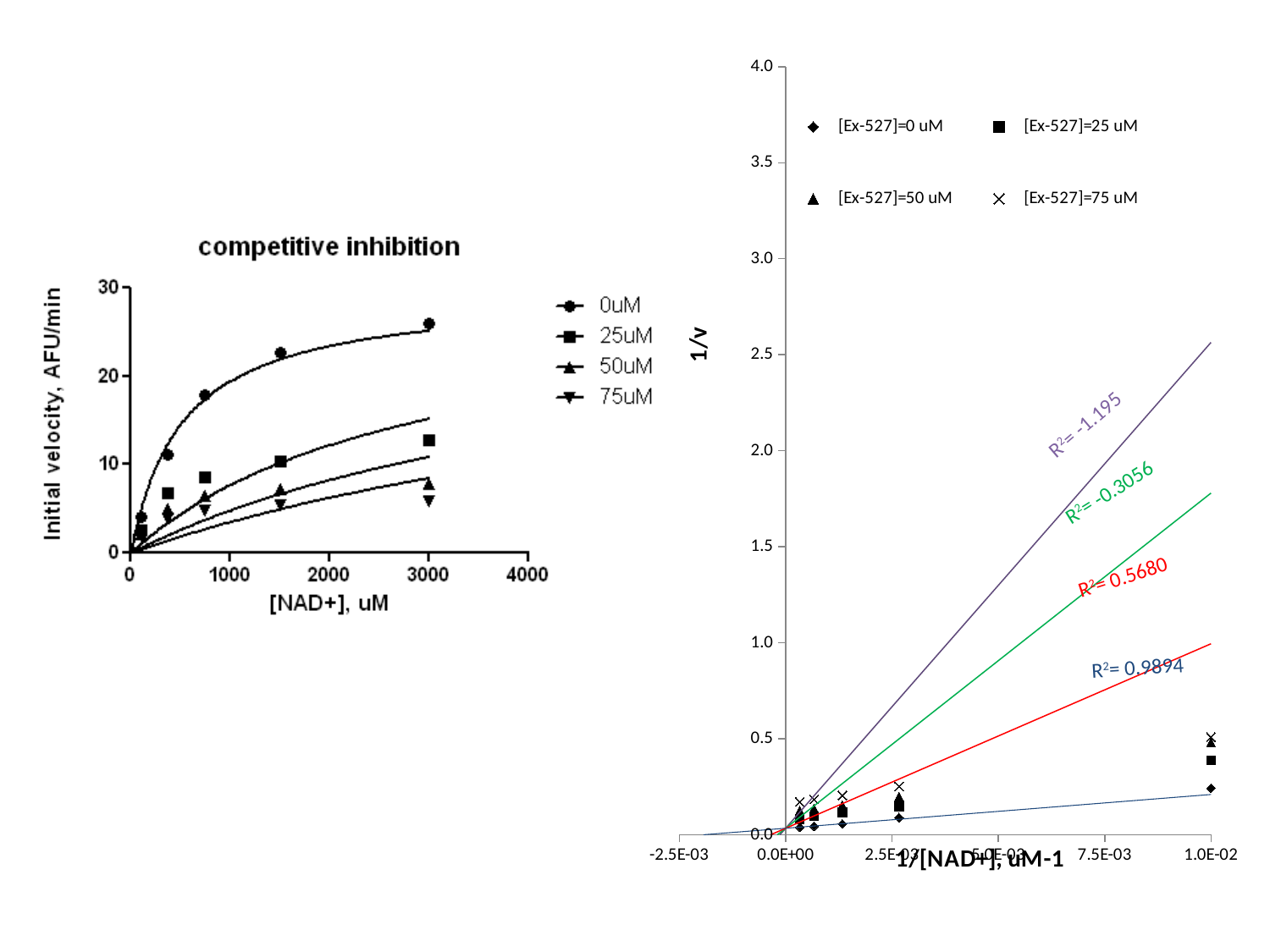
In the left chart (competitive inhibition), what is the label of the y axis? Initial velocity, AFU/min In the left chart (competitive inhibition), is the value for the 0uM series at [NAD+] = 3000 greater or less than 20? greater In the right chart (1/v versus 1/[NAD+]), is the value for the [Ex-527]=0 uM series at 1/[NAD+] = 1.0E-02 greater or less than 0.5? less What is the title of the chart on the left side of the slide? competitive inhibition In the left chart (competitive inhibition), how many series does the legend list? 4 In the right chart (1/v versus 1/[NAD+]), what R² value is printed next to the blue line? R²= 0.9894 In the right chart (1/v versus 1/[NAD+]), what R² value is printed next to the purple line? R²= -1.195 In the right chart (1/v versus 1/[NAD+]), how many series does the legend list? 4 In the left chart (competitive inhibition), at [NAD+] = 3000, which series has the larger initial velocity, 0uM or 75uM? 0uM In the left chart (competitive inhibition), does the initial velocity for the 0uM series rise or fall as [NAD+] increases? rise In the left chart (competitive inhibition), is the value for the 75uM series at [NAD+] = 3000 greater or less than 10? less In the right chart (1/v versus 1/[NAD+]), at 1/[NAD+] = 1.0E-02, which series has the larger 1/v value, [Ex-527]=0 uM or [Ex-527]=75 uM? [Ex-527]=75 uM